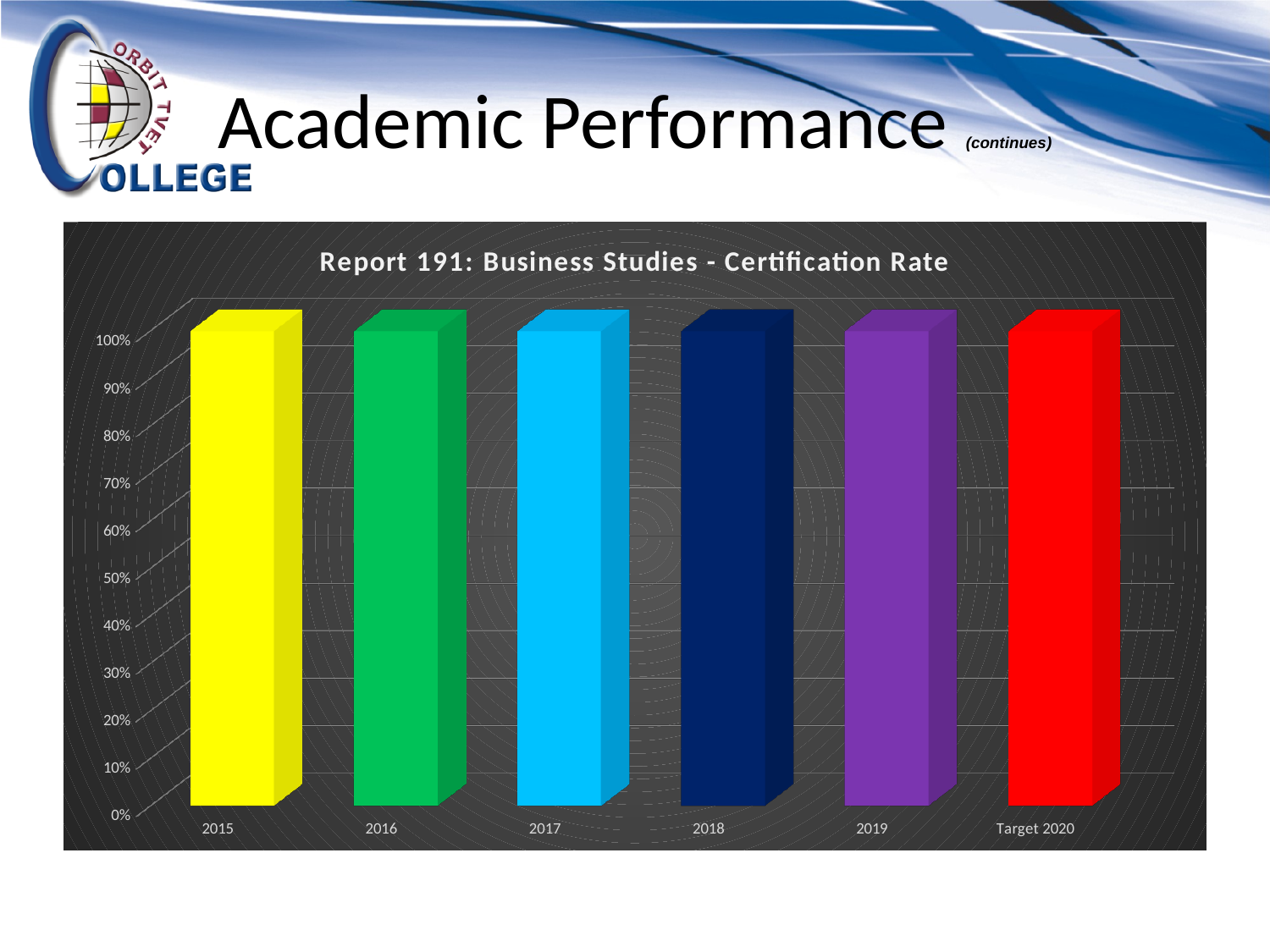
Is the value for 2016 greater or less than 80%? greater What is the highest value shown on the y axis of the chart? 100% Is the value for 2019 greater or less than 90%? greater What kind of chart is shown on the slide? bar chart Is the value for 2018 greater or less than 70%? greater What is the label of the last category on the x axis? Target 2020 How many categories are shown on the x axis of the chart? 6 What is the title of the chart? Report 191: Business Studies - Certification Rate